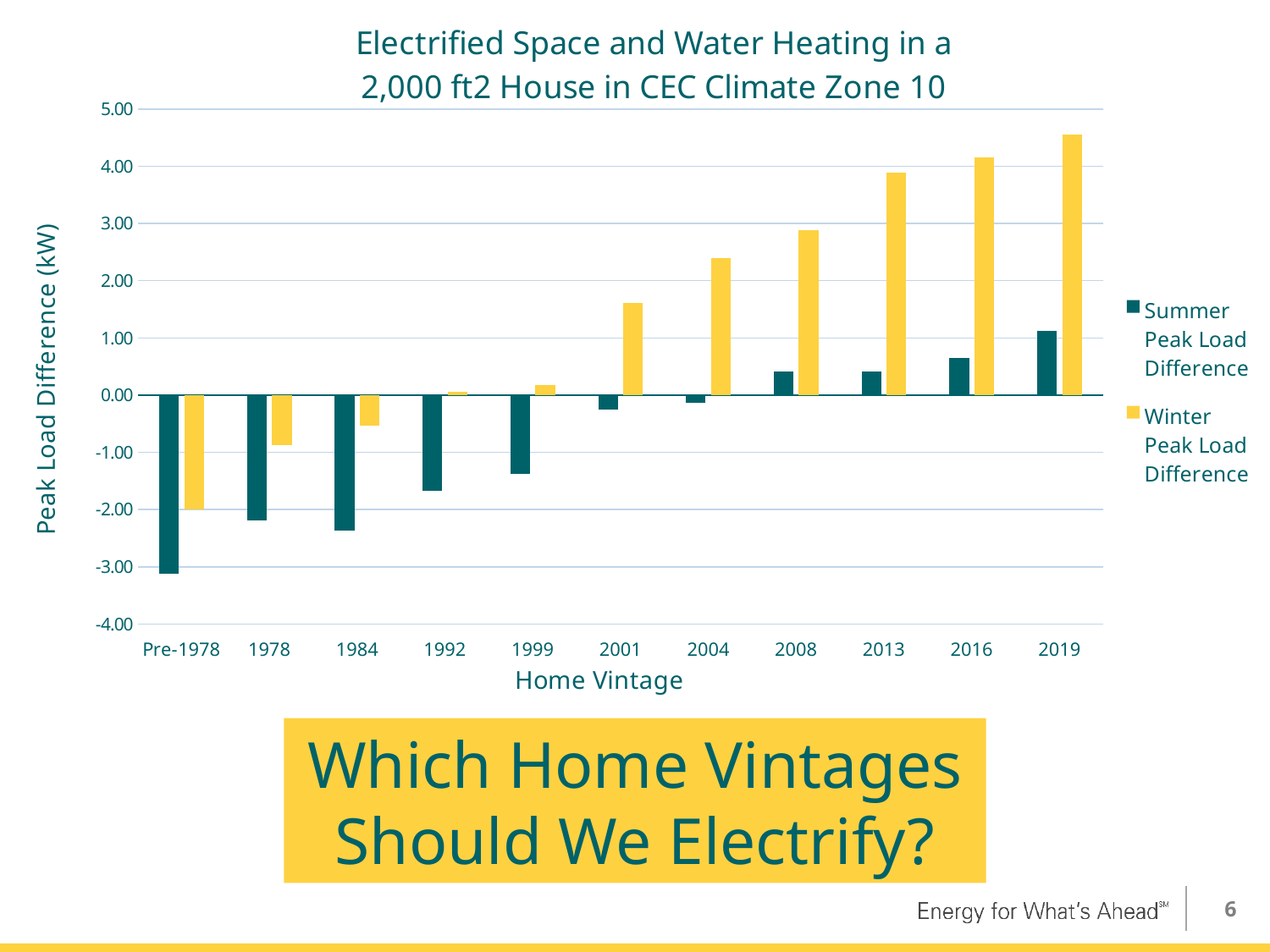
What is the label on the y axis of the chart? Peak Load Difference (kW) Is the Summer Peak Load Difference for Pre-1978 greater or less than -2.00? less Which is larger, the Winter Peak Load Difference for 2013 or for 2008? 2013 How many home vintage categories are shown on the x axis? 11 Do the Winter Peak Load Difference values rise or fall as home vintage moves from Pre-1978 to 2019? rise Is the Winter Peak Load Difference for 2019 greater or less than 4.00? greater How many series does the legend list? 2 Which home vintage has the lowest Summer Peak Load Difference? Pre-1978 Is the Winter Peak Load Difference for 2004 greater or less than 2.00? greater Which is larger, the Summer Peak Load Difference for 2019 or for 2016? 2019 Which home vintage has the highest Winter Peak Load Difference? 2019 What kind of chart is shown on the slide? Bar chart